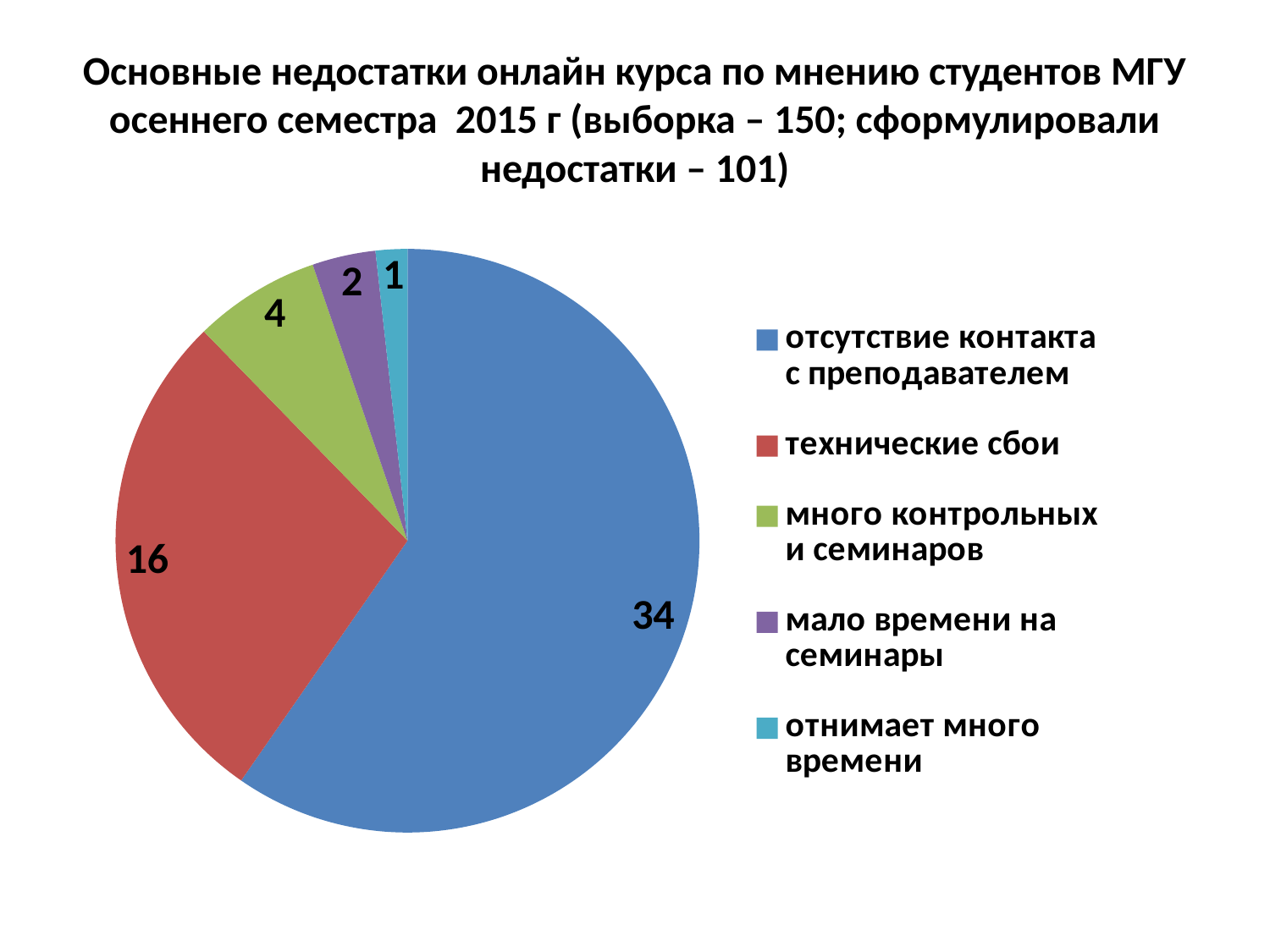
What is the value for "технические сбои"? 16 What is the value for "мало времени на семинары"? 2 What is the value for "отнимает много времени"? 1 Which category has the largest slice of the pie? отсутствие контакта с преподавателем Which category has the smallest slice of the pie? отнимает много времени What is the value for "много контрольных и семинаров"? 4 What is the value for "отсутствие контакта с преподавателем"? 34 Which is larger: the value for "много контрольных и семинаров" or the value for "мало времени на семинары"? много контрольных и семинаров How many categories does the pie chart have? 5 What colour is the slice for "технические сбои"? red What kind of chart is shown on the slide? pie chart What is the difference between the values for "отсутствие контакта с преподавателем" and "технические сбои"? 18